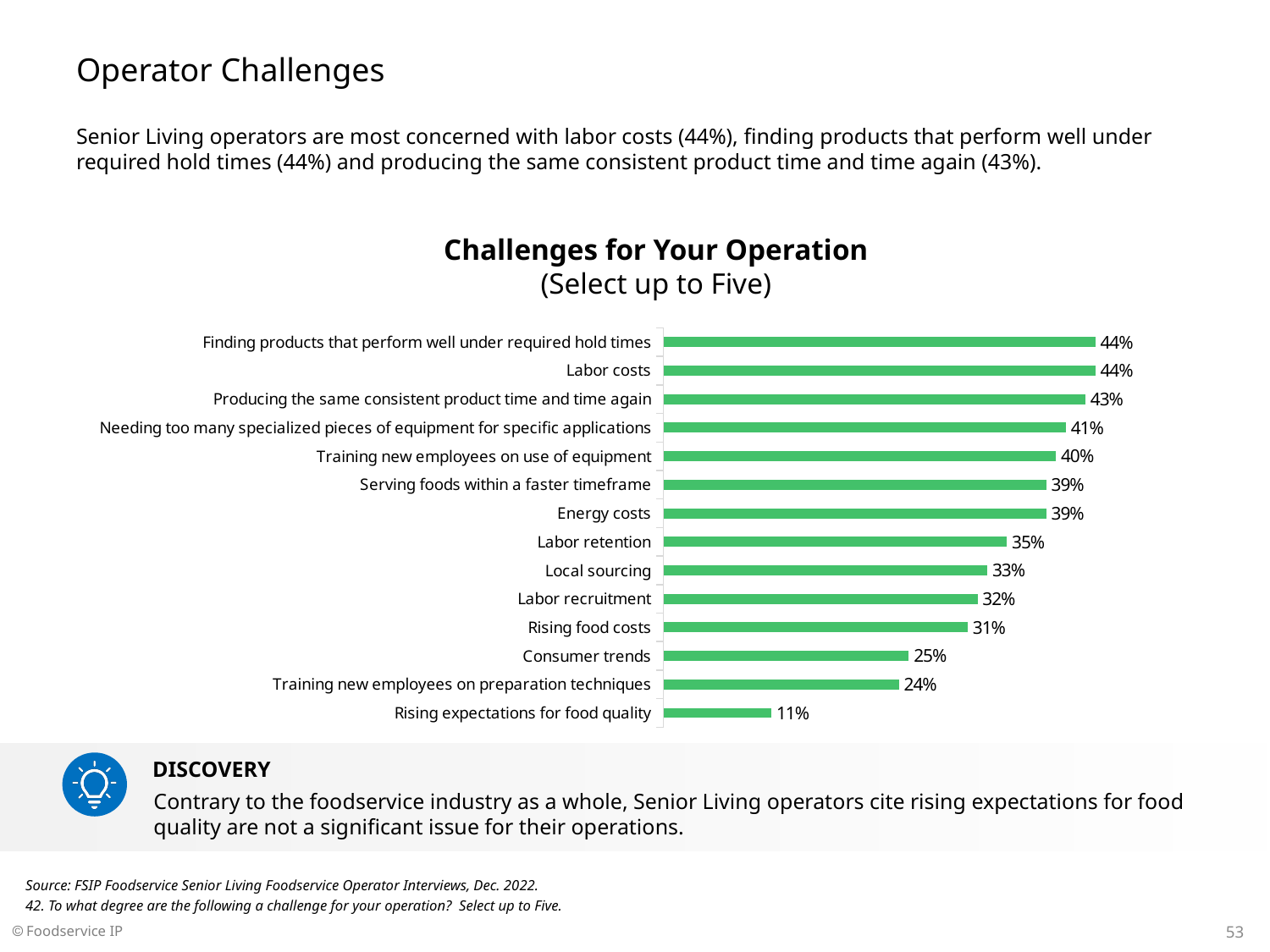
What is the difference between Labor retention and Labor recruitment? 3% What is the value for Rising food costs? 31% What is the value for Labor costs? 44% What is the value for Energy costs? 39% What is the value for Training new employees on preparation techniques? 24% How many categories are shown in the chart? 14 Which is larger, Local sourcing or Consumer trends? Local sourcing What is the difference between Producing the same consistent product time and time again and Consumer trends? 18% What kind of chart is shown on the slide? Bar chart What is the title of the chart? Challenges for Your Operation (Select up to Five) Which category has the lowest value? Rising expectations for food quality Which is larger, Training new employees on use of equipment or Labor retention? Training new employees on use of equipment